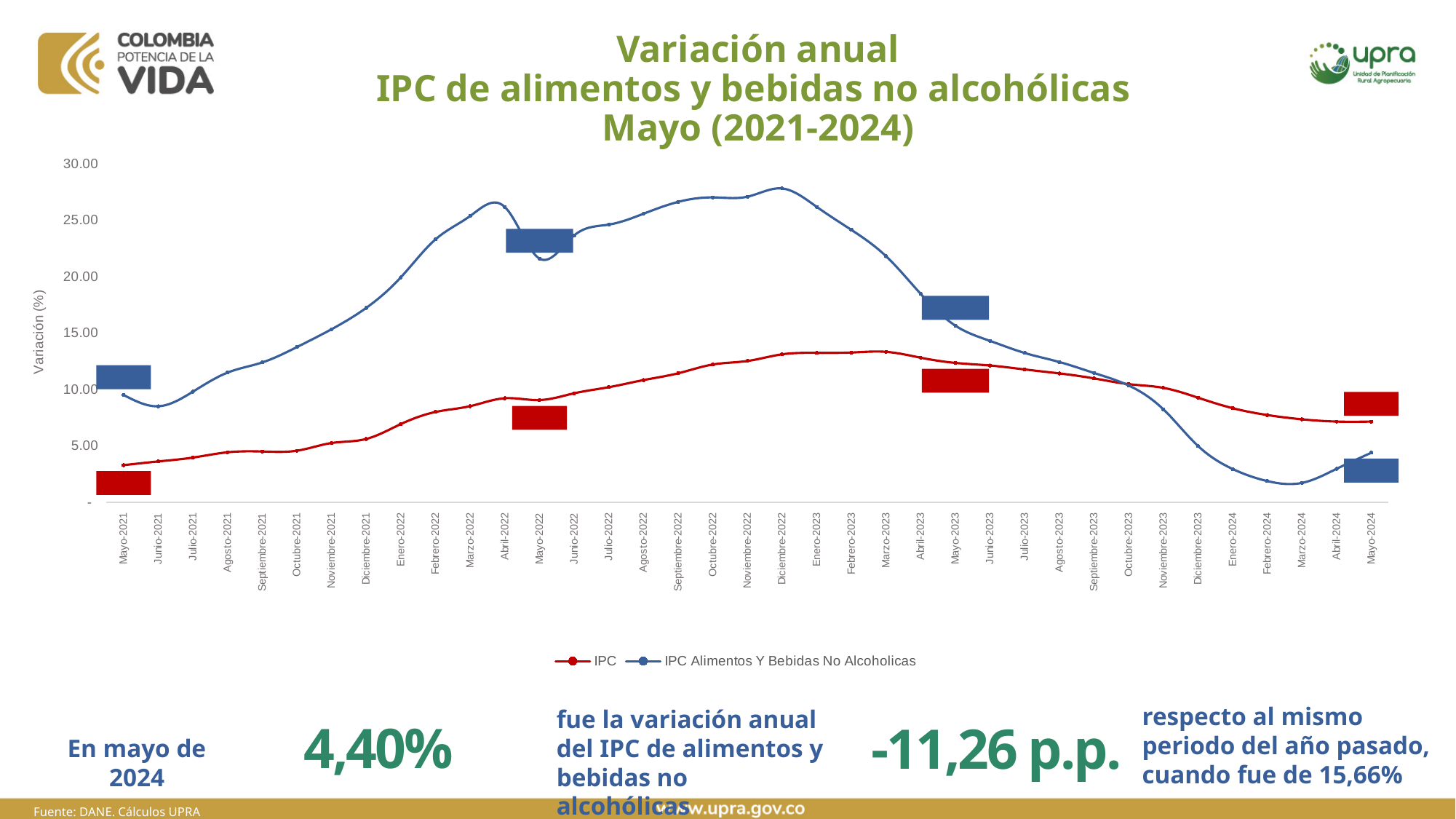
Is the value of IPC for Mayo-2021 greater or less than 5? less In which month does the IPC Alimentos Y Bebidas No Alcoholicas series reach its highest value? Diciembre-2022 Is the value of IPC Alimentos Y Bebidas No Alcoholicas for Marzo-2024 greater or less than 5? less Is the value of IPC Alimentos Y Bebidas No Alcoholicas for Diciembre-2022 greater or less than 25? greater In which month does the IPC series reach its lowest value? Mayo-2021 Does the IPC Alimentos Y Bebidas No Alcoholicas series rise or fall between Diciembre-2022 and Marzo-2024? fall How many series does the legend list? 2 What colour is the IPC series line in the legend? red In Mayo-2024, which series has the larger value, IPC or IPC Alimentos Y Bebidas No Alcoholicas? IPC How many monthly points are plotted along the x axis, from Mayo-2021 to Mayo-2024? 37 What kind of chart is shown on the slide? line chart According to the slide, what was the annual variation of the IPC de alimentos y bebidas no alcohólicas in May 2024? 4,40%